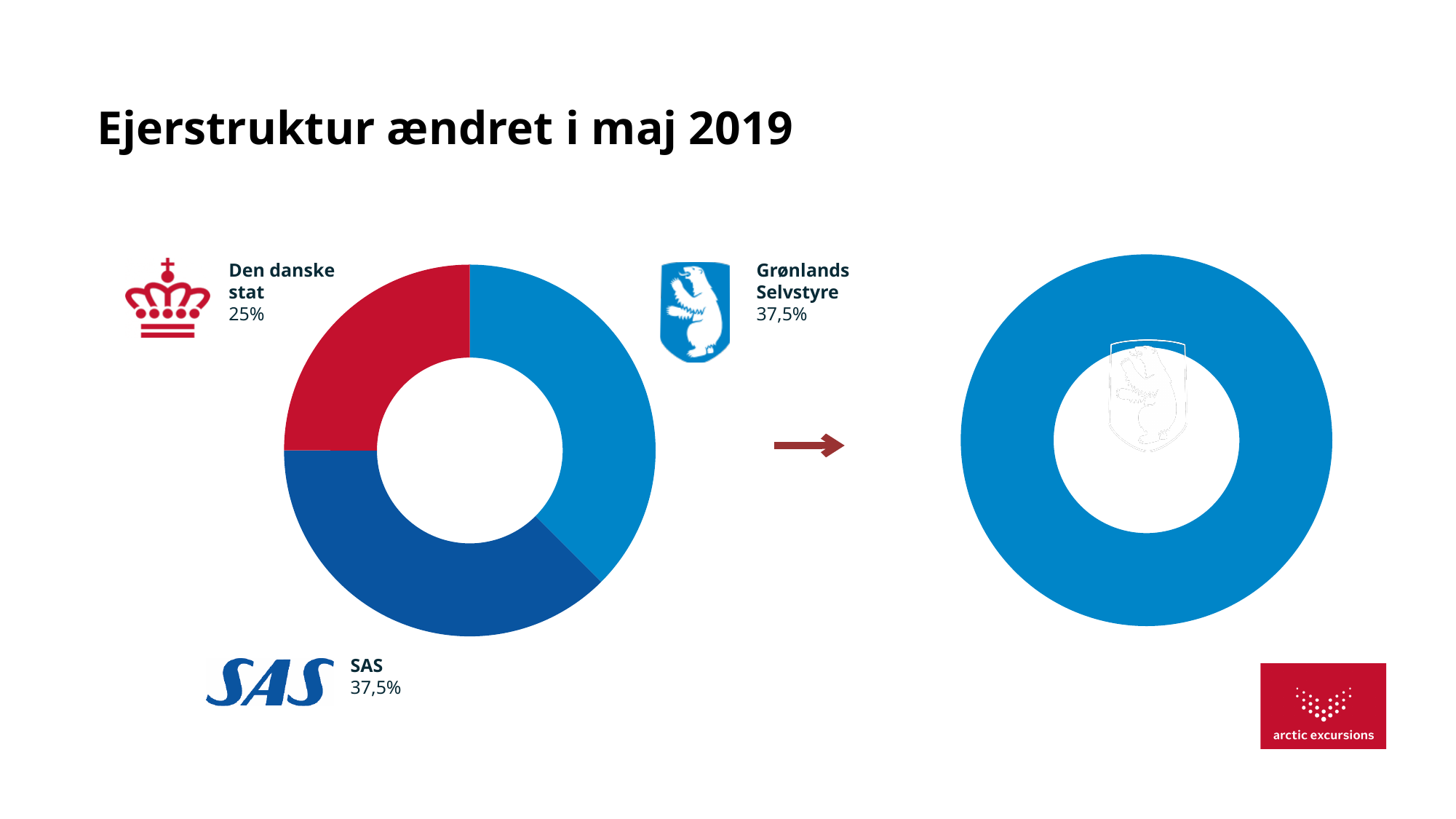
In the left donut chart, what share does Grønlands Selvstyre hold? 37,5% In the left donut chart, what is the combined share of SAS and Grønlands Selvstyre? 75% In the left donut chart, what colour is the slice for Den danske stat? Red In the left donut chart, what share does Den danske stat hold? 25% In the left donut chart, do SAS and Grønlands Selvstyre hold the same share? Yes How many slices does the right donut chart have? 1 What kind of chart is shown on the left of the slide? Pie chart (donut) In the left donut chart, which owner has the smallest share? Den danske stat In the left donut chart, which is larger: the share of SAS or the share of Den danske stat? SAS In the left donut chart, what share does SAS hold? 37,5% In the left donut chart, how much larger is the share of SAS than the share of Den danske stat? 12,5% How many slices does the left donut chart have? 3